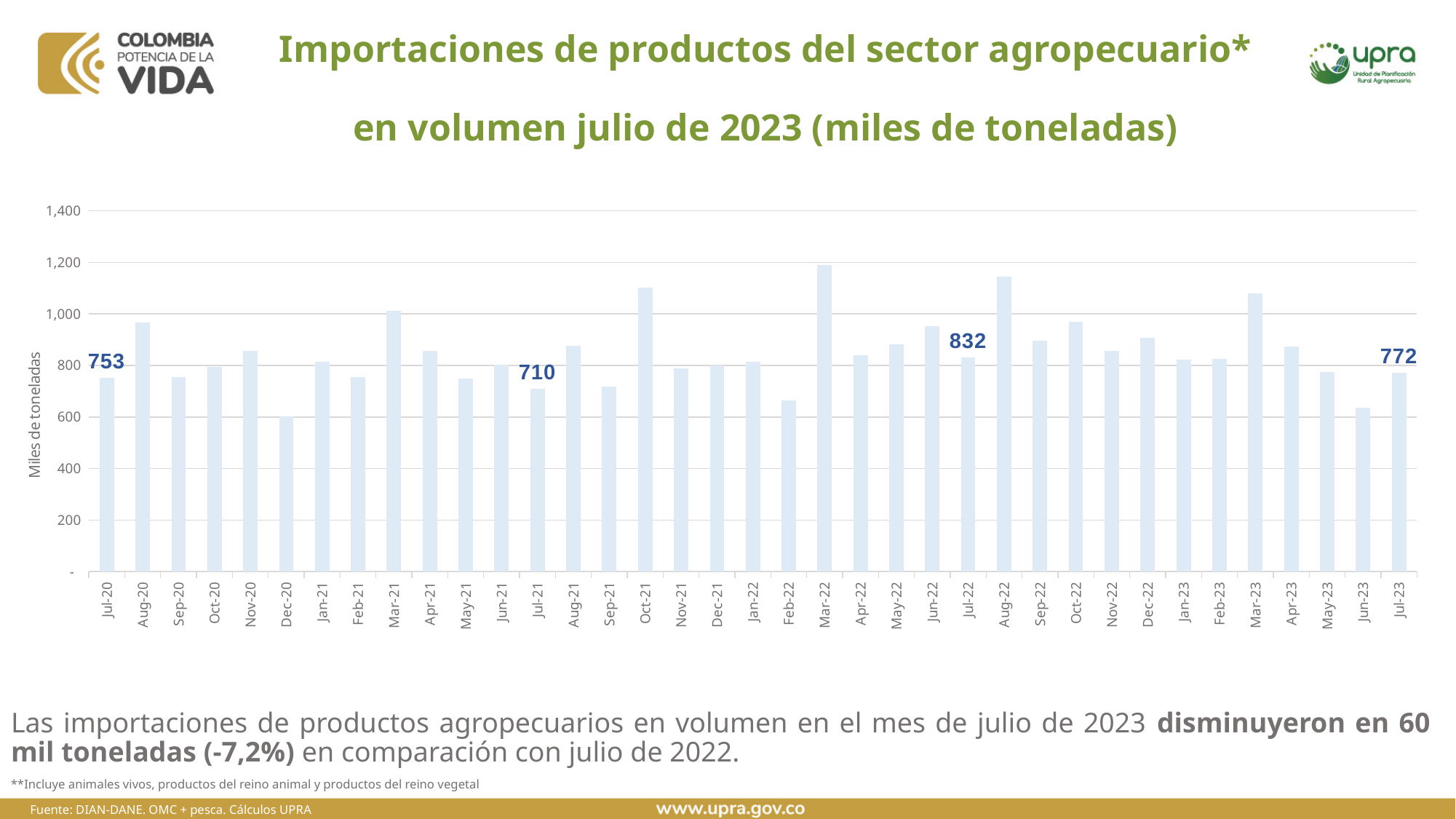
What kind of chart is shown? bar chart Which is larger, the value for Jul-22 or the value for Jul-23? Jul-22 What is the value for Jul-22? 832 What is the value for Jul-20? 753 Which month has the highest value? Mar-22 Is the value for Mar-23 greater or less than 1,000? greater What is the value for Jul-23? 772 What is the difference between the values for Jul-22 and Jul-23? 60 How many months are plotted on the chart? 37 Is the value for Feb-22 greater or less than 800? less What is the value for Jul-21? 710 What is the difference between the values for Jul-22 and Jul-21? 122